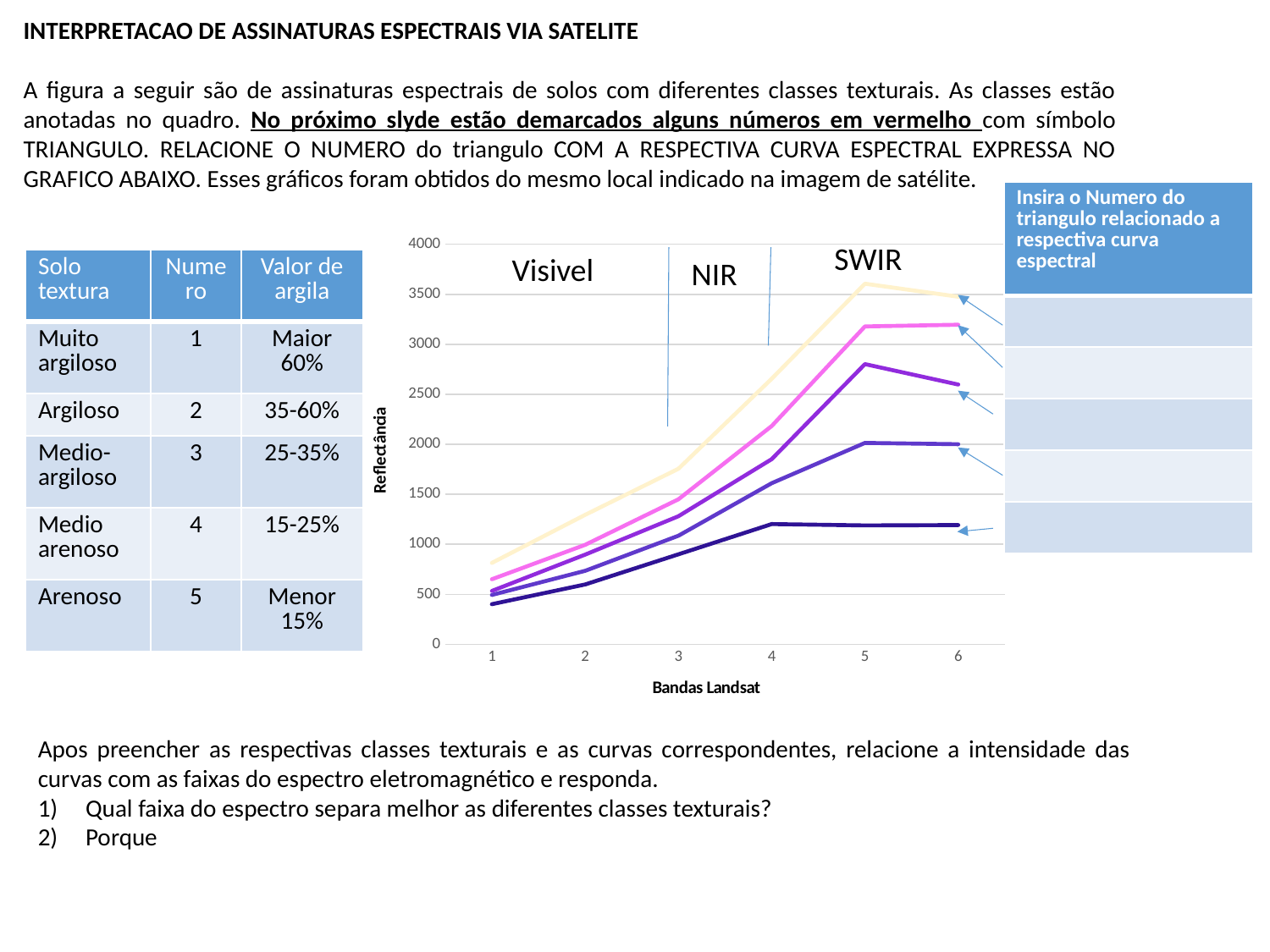
What kind of chart is shown on the slide? line chart Is the reflectance of the dark navy (bottom) curve at band 6 greater or less than 1500? less Which curve has the lowest reflectance at band 5? the dark navy (bottom) curve What is the title of the x axis of the chart? Bandas Landsat Is the reflectance of the light yellow (top) curve at band 5 greater or less than 3000? greater Is the reflectance of the pink curve at band 6 greater or less than 3000? greater At band 3, is the reflectance of the pink curve larger or smaller than that of the dark navy curve? larger How many Landsat bands are shown along the x axis of the chart? 6 Do the curves generally rise or fall from band 1 to band 5? rise Which curve has the highest reflectance at band 5? the light yellow (top) curve What is the title of the y axis of the chart? Reflectância How many spectral curves (lines) are plotted on the chart? 5